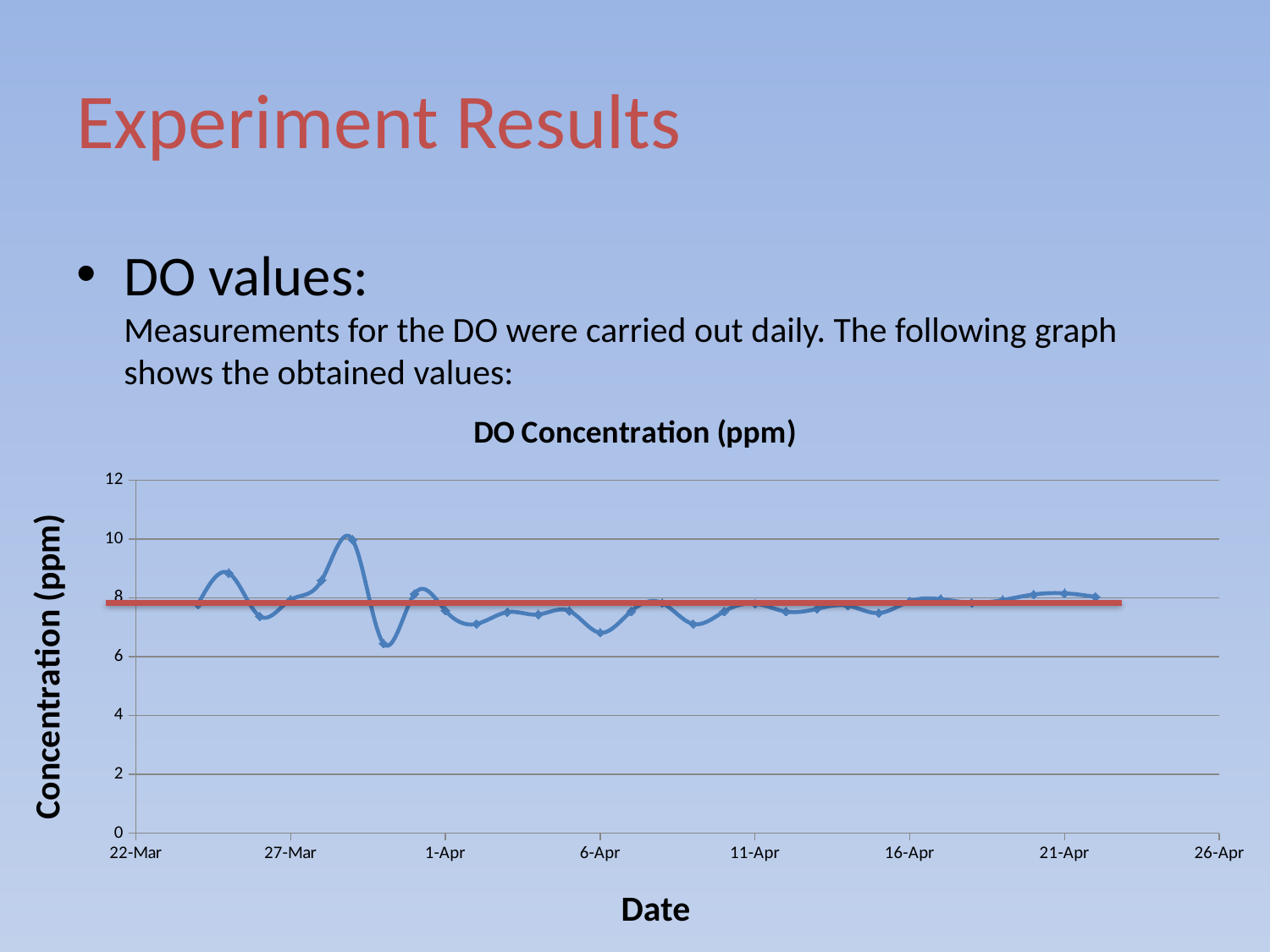
What is the highest value shown on the vertical axis of the chart? 12 Is the DO concentration value at the peak between 27-Mar and 1-Apr greater or less than 6? greater What is the last date label on the horizontal axis of the chart? 26-Apr Is the DO concentration value at the lowest dip between 27-Mar and 1-Apr greater or less than 4? greater What kind of chart is shown on the slide? line chart What is the label on the vertical axis of the chart? Concentration (ppm) Does the peak DO concentration occur before or after 1-Apr? before How many date labels are shown on the horizontal axis of the chart? 8 What is the first date label on the horizontal axis of the chart? 22-Mar What is the title of the chart? DO Concentration (ppm) Is the highest DO concentration value plotted on the chart greater or less than 8? greater